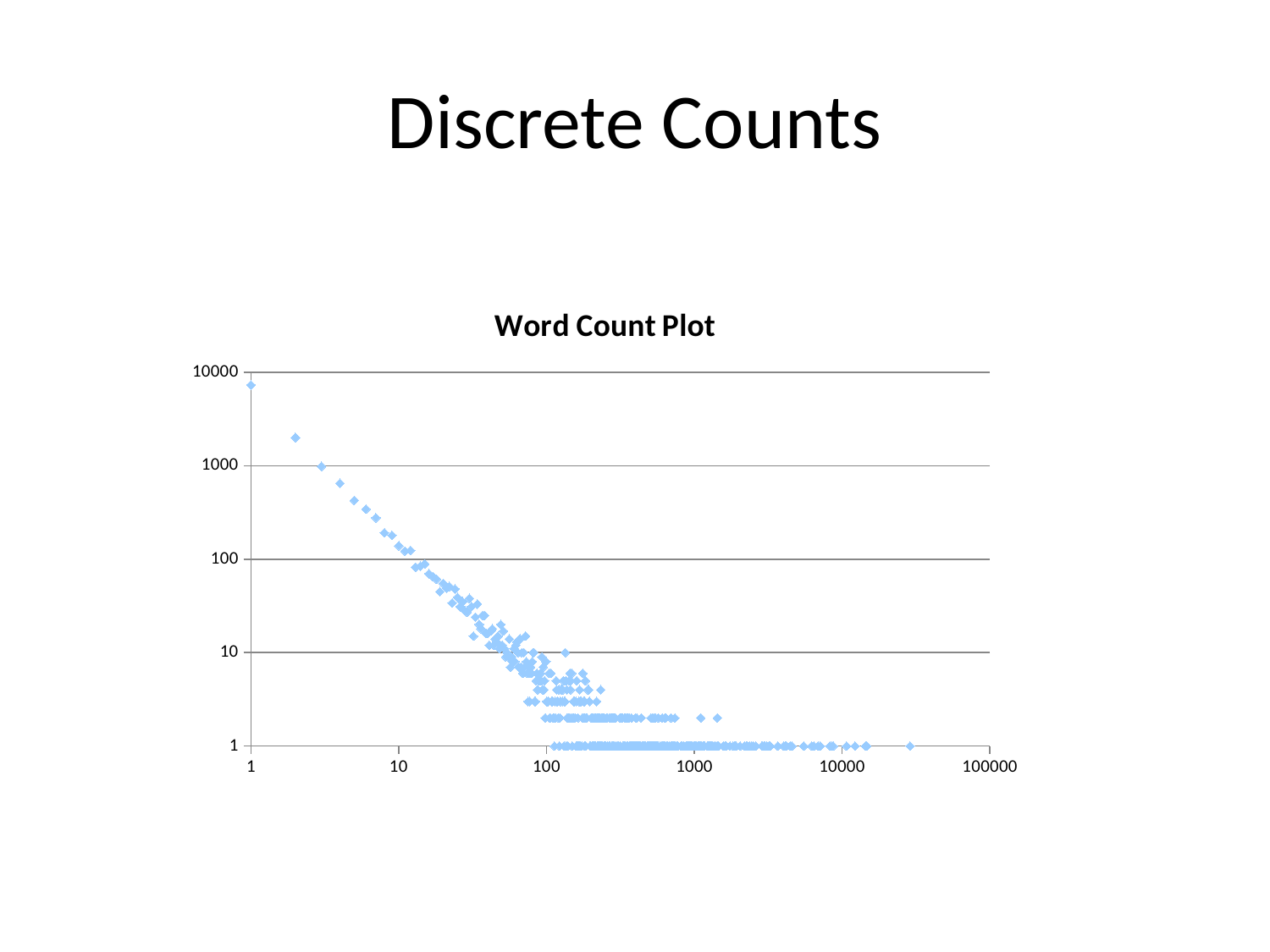
What is the highest value labelled on the x axis? 100000 Is the value of the point at x = 1 greater or less than 1000? greater What is the title of the chart? Word Count Plot Is the value of the point at x = 100 greater or less than 10? less What is the lowest y value that the plotted points reach? 1 Do the plotted values rise or fall as the x axis increases? fall Is the value of the point at x = 10 greater or less than 100? greater What kind of chart is shown on the slide? scatter plot Which point has the highest y value: the point at x = 1 or the point at x = 10? the point at x = 1 What is the lowest value shown on the y axis? 1